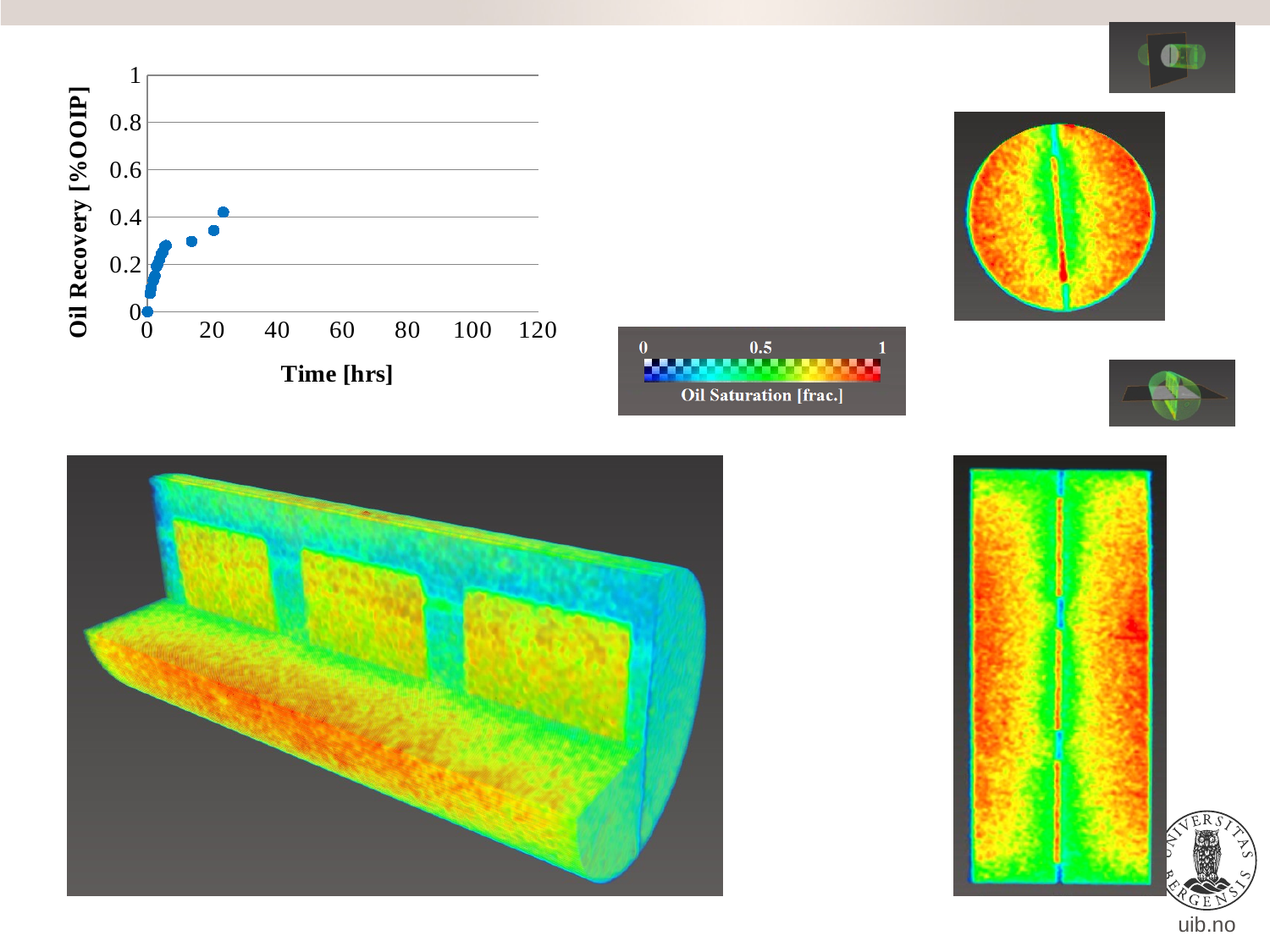
What is the maximum value shown on the x axis of the chart? 120 Is the highest plotted oil recovery value greater or less than 0.6? less Is the oil recovery value plotted at around 13 hours greater or less than 0.4? less What kind of chart is shown on the slide? scatter chart What is the title of the x axis of the chart? Time [hrs] Is the highest plotted oil recovery value greater or less than 0.2? greater What is the title of the y axis of the chart? Oil Recovery [%OOIP] Do the plotted oil recovery values rise or fall as time increases? rise